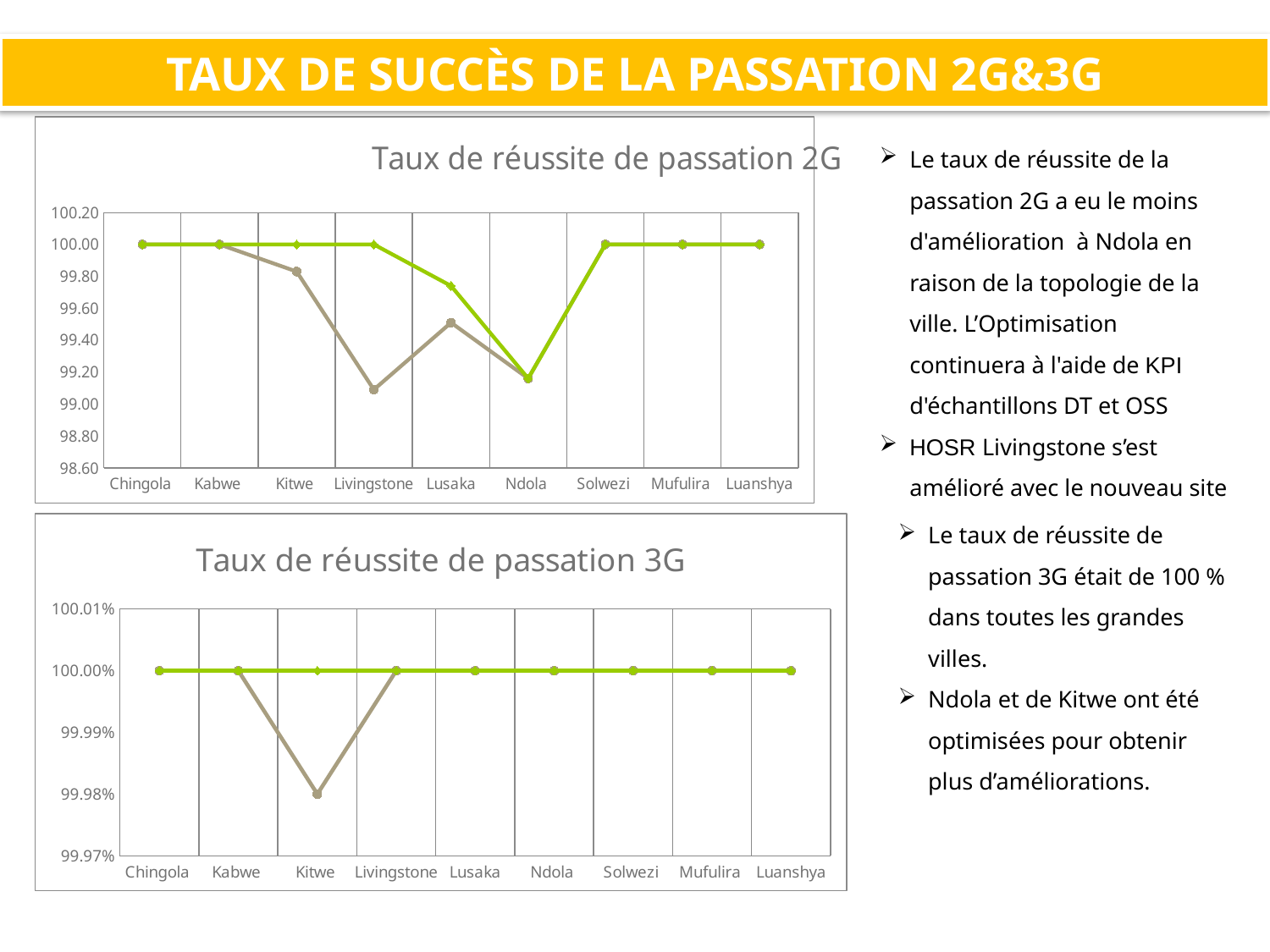
What kind of chart is 'Taux de réussite de passation 2G'? line chart In the 'Taux de réussite de passation 3G' chart, is the grey line value for Kitwe greater or less than 99.99%? less In the 'Taux de réussite de passation 2G' chart, is the grey line value for Livingstone greater or less than 99.20? less In the 'Taux de réussite de passation 2G' chart, is the grey line value for Kitwe greater or less than 99.60? greater In the 'Taux de réussite de passation 3G' chart, at which city does the grey line reach its lowest point? Kitwe How many cities are shown on the x axis of the 'Taux de réussite de passation 2G' chart? 9 In the 'Taux de réussite de passation 2G' chart, what is the value of the green line at Chingola? 100.00 In the 'Taux de réussite de passation 3G' chart, what is the value of the green line at Ndola? 100.00% In the 'Taux de réussite de passation 2G' chart, at which city does the grey line reach its lowest point? Livingstone In the 'Taux de réussite de passation 2G' chart, at which city does the green line reach its lowest point? Ndola How many cities are shown on the x axis of the 'Taux de réussite de passation 3G' chart? 9 In the 'Taux de réussite de passation 2G' chart, which is higher at Lusaka, the green line or the grey line? the green line